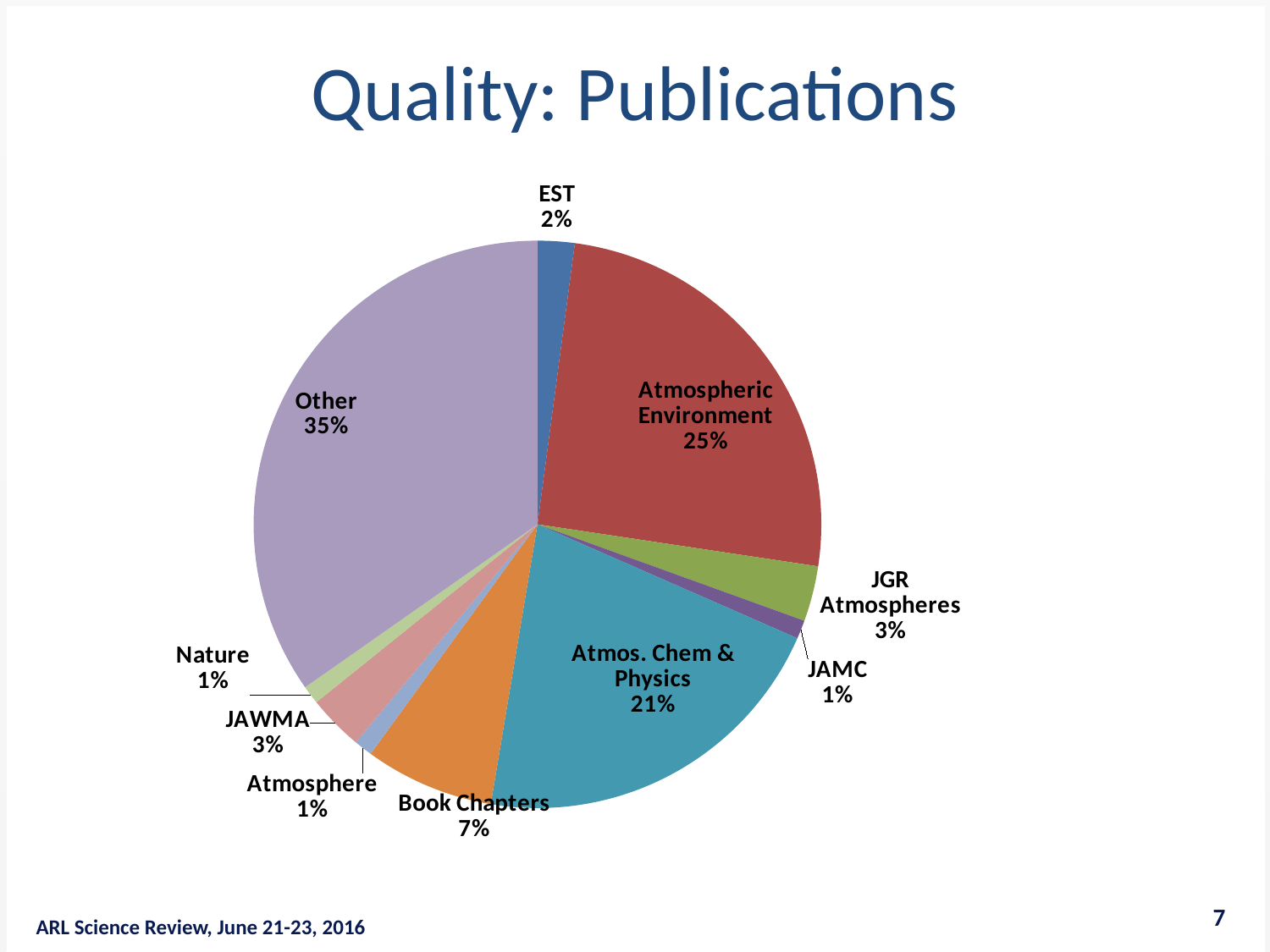
What percentage is shown for Book Chapters? 7% Which category has the largest slice of the pie? Other What is the difference between the Other share and the Atmospheric Environment share? 10% Which is larger, the share for Atmos. Chem & Physics or the share for Book Chapters? Atmos. Chem & Physics What is the combined share of JAWMA and Nature? 4% What share of publications is Atmospheric Environment? 25% What kind of chart is shown on the slide? pie chart What percentage is shown for JGR Atmospheres? 3% What percentage is shown for EST? 2% How many slices does the pie chart have? 10 What is the title of the slide containing the pie chart? Quality: Publications What share of publications is Atmos. Chem & Physics? 21%